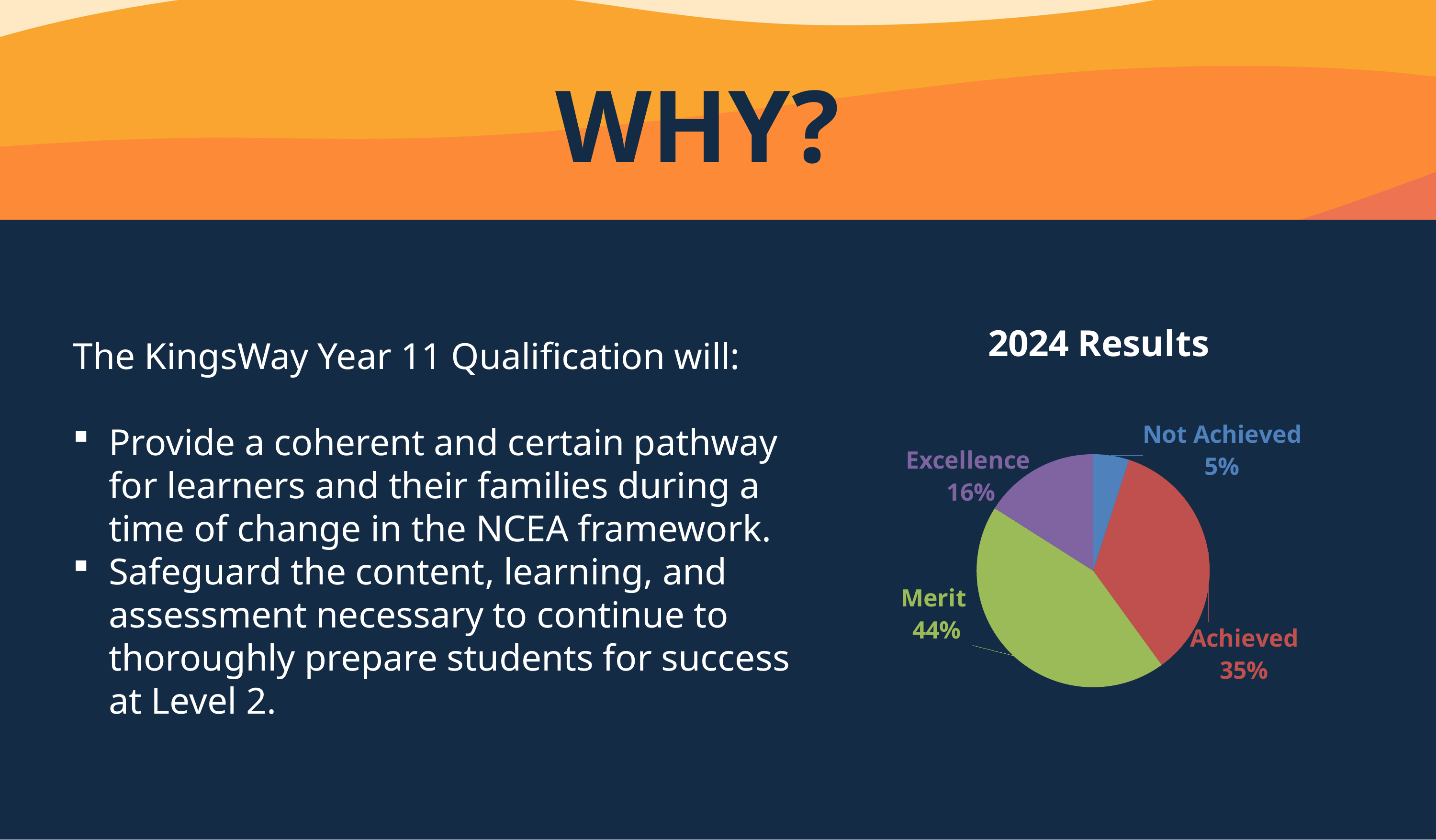
How many slices does the pie chart have? 4 What percentage of the pie is Merit? 44% What is the title of the chart? 2024 Results Which is larger, the share for Excellence or the share for Not Achieved? Excellence What percentage of the pie is Achieved? 35% Which category has the smallest share of the pie? Not Achieved What percentage of the pie is Excellence? 16% What type of chart is shown on the slide? pie chart What colour is the Merit slice? green Which category has the largest share of the pie? Merit What is the difference in percentage points between Merit and Achieved? 9 What percentage of the pie is Not Achieved? 5%